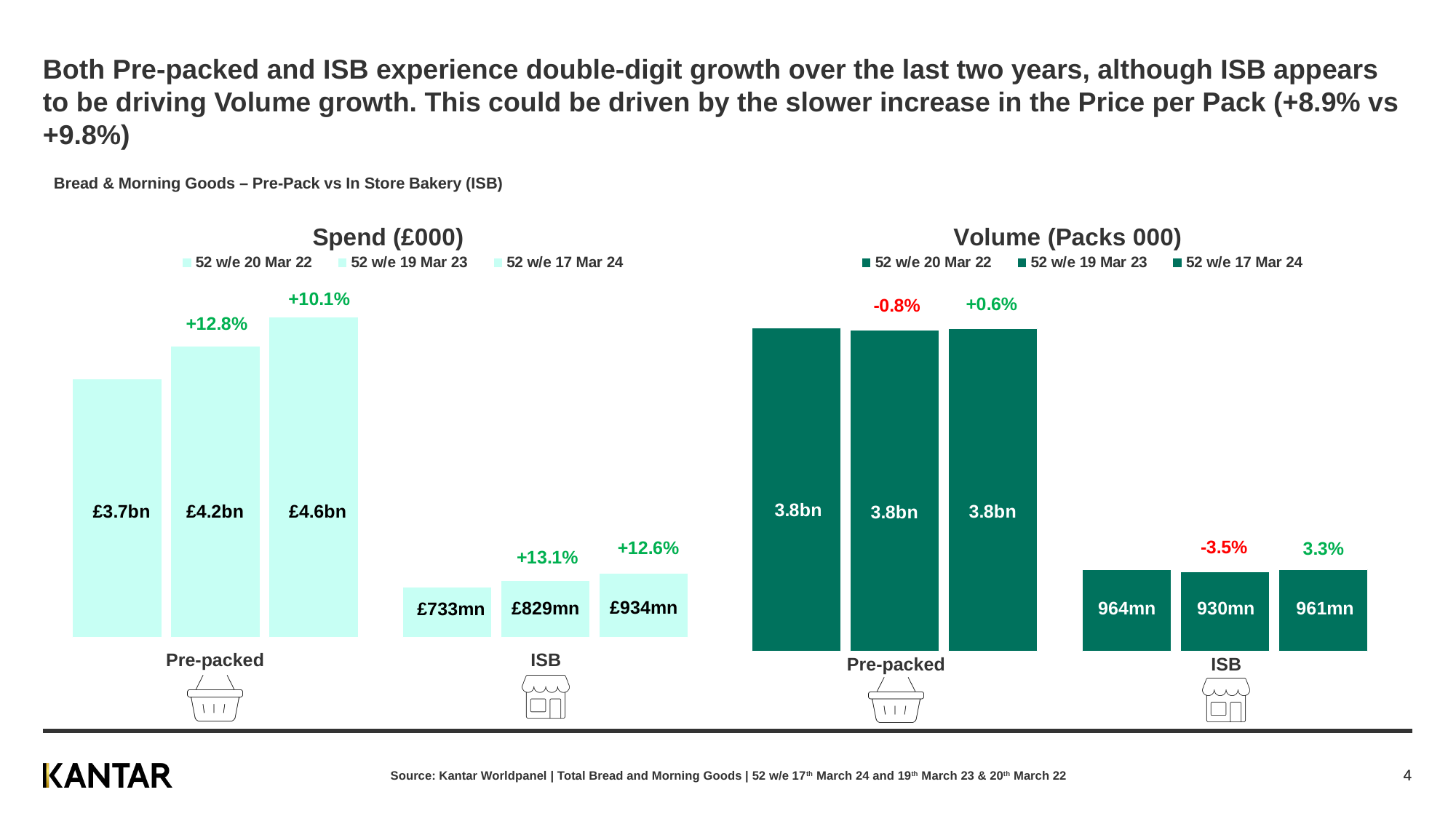
In the Volume (Packs 000) chart, what is the difference between the ISB volume for 52 w/e 20 Mar 22 and 52 w/e 19 Mar 23? 34mn What kind of chart is the Spend (£000) chart? Bar chart In the Spend (£000) chart, what is the ISB spend for 52 w/e 20 Mar 22? £733mn How many series does the legend of the Volume (Packs 000) chart list? 3 In the Volume (Packs 000) chart, which period has the lowest ISB volume? 52 w/e 19 Mar 23 In the Spend (£000) chart, what is the difference between the ISB spend for 52 w/e 17 Mar 24 and 52 w/e 19 Mar 23? £105mn In the Volume (Packs 000) chart, what is the ISB volume for 52 w/e 19 Mar 23? 930mn In the Volume (Packs 000) chart, what is the Pre-packed volume for 52 w/e 20 Mar 22? 3.8bn In the Spend (£000) chart, what is the Pre-packed spend for 52 w/e 17 Mar 24? £4.6bn In the Spend (£000) chart, which period has the highest Pre-packed spend? 52 w/e 17 Mar 24 In the Spend (£000) chart, do the ISB spend values rise or fall from 52 w/e 20 Mar 22 to 52 w/e 17 Mar 24? Rise In the Spend (£000) chart, which is larger: the Pre-packed spend for 52 w/e 20 Mar 22 or the ISB spend for 52 w/e 17 Mar 24? Pre-packed spend for 52 w/e 20 Mar 22